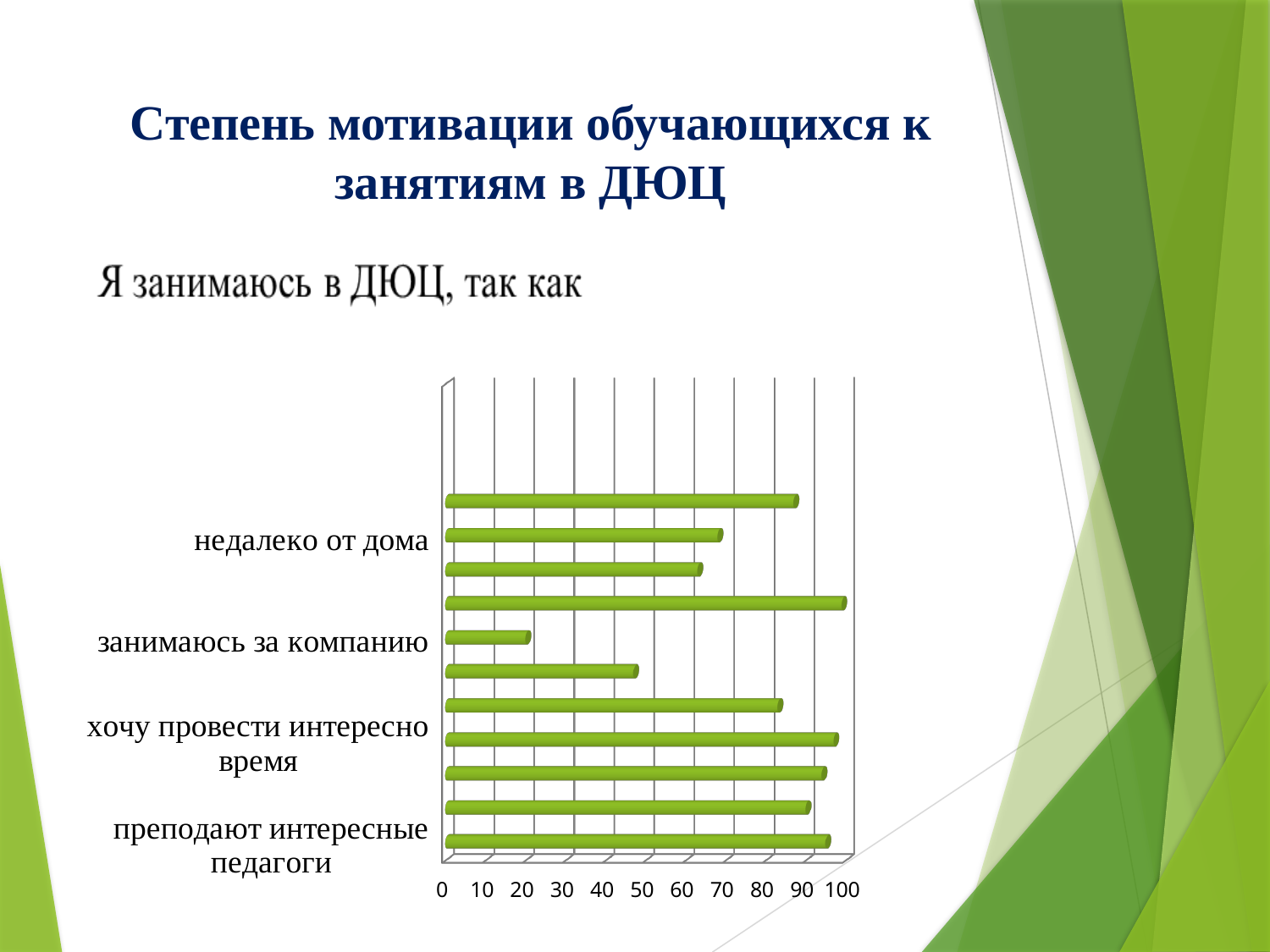
Which has the larger value, "недалеко от дома" or "занимаюсь за компанию"? недалеко от дома Is the value for "занимаюсь за компанию" greater or less than 30? less Is the value for "недалеко от дома" greater or less than 50? greater Is the value for "хочу провести интересно время" greater or less than 90? greater What kind of chart is shown on the slide? bar chart How many bars are plotted in the chart? 11 Which labelled category has the lowest value in the chart? занимаюсь за компанию What heading is printed above the chart? Я занимаюсь в ДЮЦ, так как Which has the larger value, "хочу провести интересно время" or "занимаюсь за компанию"? хочу провести интересно время What is the highest value shown on the horizontal axis of the chart? 100